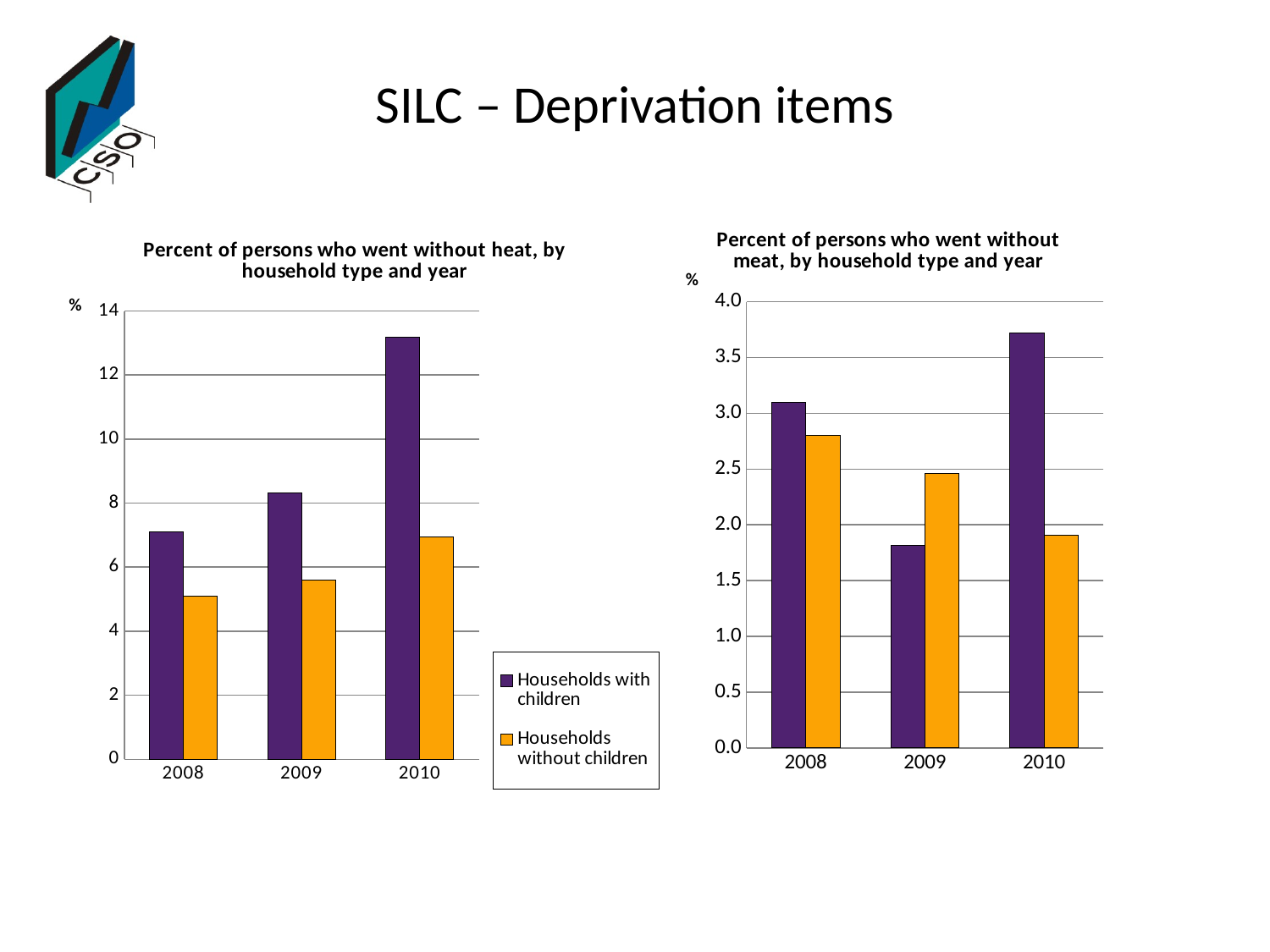
In the chart 'Percent of persons who went without meat, by household type and year', which is larger in 2009: Households with children or Households without children? Households without children In the chart 'Percent of persons who went without meat, by household type and year', which year has the lowest value for Households with children? 2009 In the chart 'Percent of persons who went without heat, by household type and year', which year has the highest value for Households with children? 2010 In the chart 'Percent of persons who went without meat, by household type and year', is the value for Households with children in 2010 greater or less than 3.5? greater In the chart 'Percent of persons who went without heat, by household type and year', do the values for Households with children rise or fall from 2008 to 2010? rise How many years are shown on the x axis of the chart 'Percent of persons who went without heat, by household type and year'? 3 In the chart 'Percent of persons who went without heat, by household type and year', is the value for Households with children in 2010 greater or less than 12? greater In the chart 'Percent of persons who went without heat, by household type and year', is the value for Households without children in 2008 greater or less than 6? less In the chart 'Percent of persons who went without heat, by household type and year', which is larger in 2009: Households with children or Households without children? Households with children What kind of chart is 'Percent of persons who went without meat, by household type and year'? bar chart How many series does the legend list for the chart 'Percent of persons who went without heat, by household type and year'? 2 In the chart 'Percent of persons who went without meat, by household type and year', do the values for Households without children rise or fall from 2008 to 2010? fall